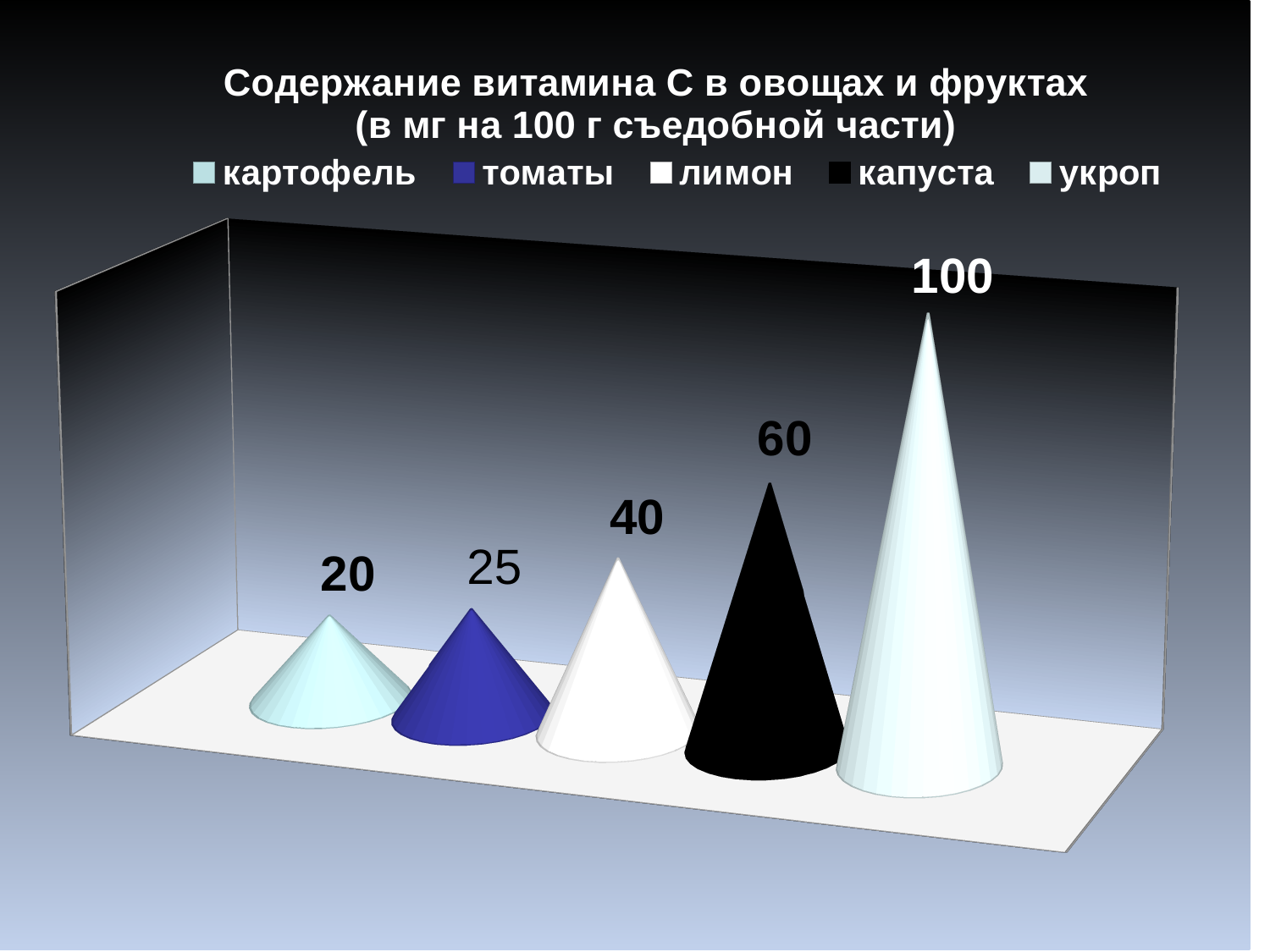
How many items are plotted on the chart? 5 What is the vitamin C content shown for укроп? 100 What is the title of the chart? Содержание витамина С в овощах и фруктах (в мг на 100 г съедобной части) What is the vitamin C content shown for томаты? 25 What is the vitamin C content shown for капуста? 60 What is the vitamin C content shown for лимон? 40 What is the vitamin C content shown for картофель? 20 Which item has the lowest vitamin C content on the chart? картофель Which item has the highest vitamin C content on the chart? укроп How many entries does the legend list? 5 What is the difference between the values for укроп and капуста? 40 Which has a higher vitamin C content, лимон or томаты? лимон